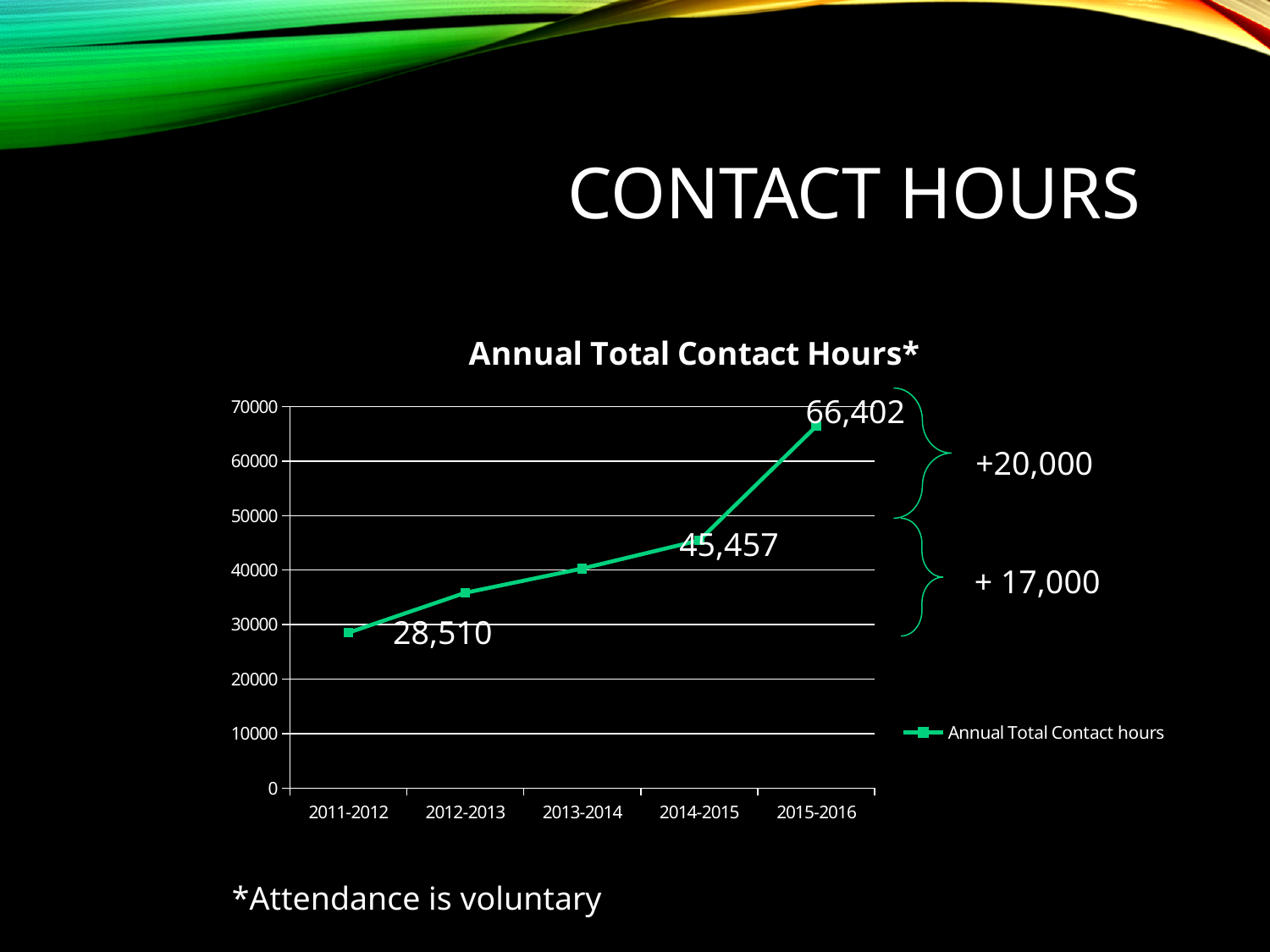
Is the value for 2012-2013 greater or less than 30000? greater What kind of chart is shown on the slide? Line chart What is the value for 2014-2015 in the Annual Total Contact Hours chart? 45,457 Which year has the highest annual total contact hours? 2015-2016 Which is larger, the contact hours for 2012-2013 or for 2014-2015? 2014-2015 What is the value for 2011-2012 in the Annual Total Contact Hours chart? 28,510 What is the difference between the contact hours for 2015-2016 and 2014-2015? 20,945 Which year has the lowest annual total contact hours? 2011-2012 What is the difference between the contact hours for 2014-2015 and 2011-2012? 16,947 What is the value for 2015-2016 in the Annual Total Contact Hours chart? 66,402 How many years are plotted on the x axis of the chart? 5 Is the value for 2013-2014 greater or less than 50000? less